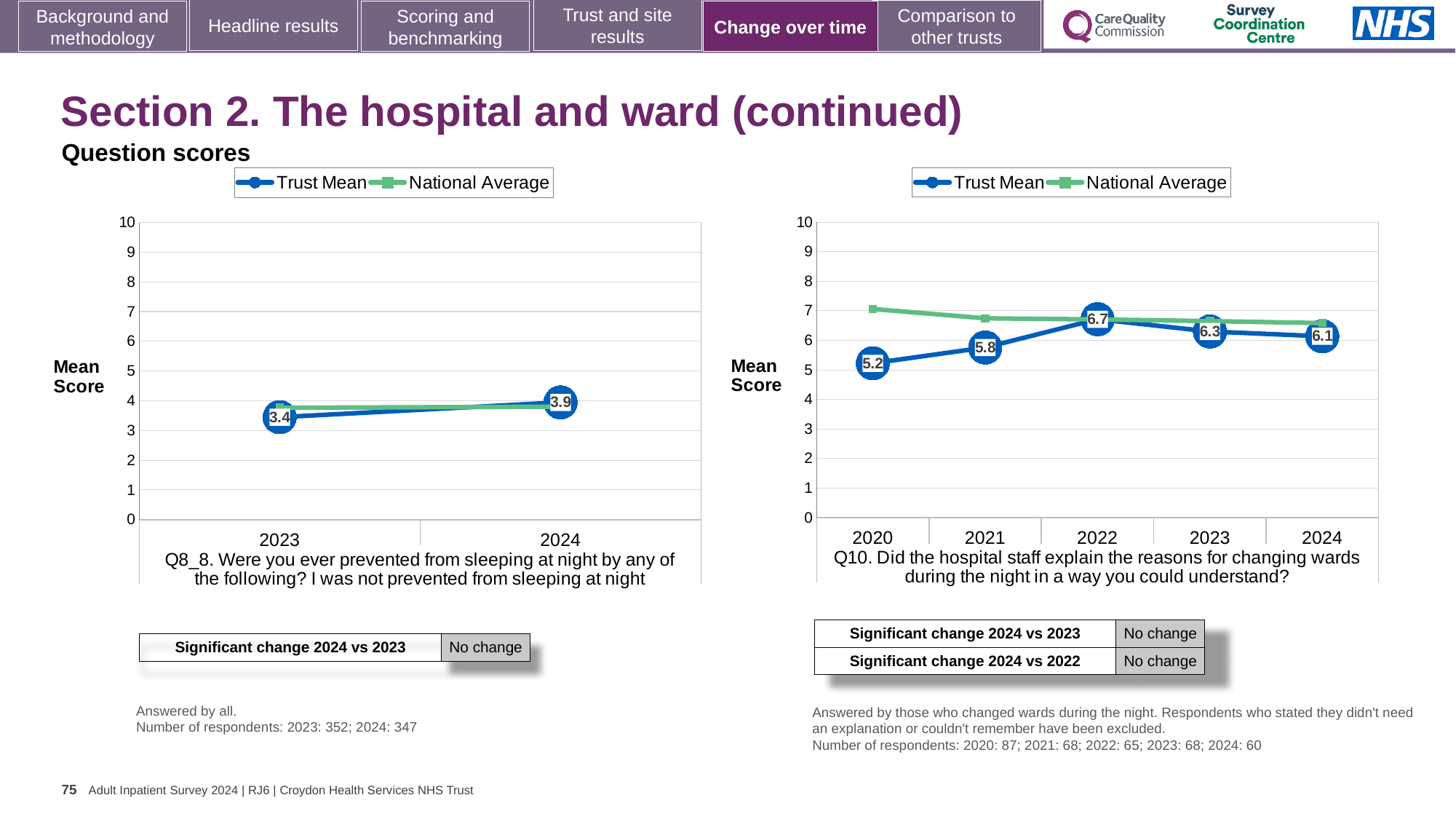
In the right chart (Q10), which year has the highest Trust Mean score? 2022 In the right chart (Q10), is the Trust Mean score for 2021 larger or smaller than the score for 2023? smaller In the left chart (Q8_8), what is the Trust Mean score for 2024? 3.9 In the right chart (Q10), which year has the lowest Trust Mean score? 2020 In the right chart (Q10), what is the Trust Mean score for 2020? 5.2 How many years are plotted on the x axis of the right chart (Q10)? 5 In the left chart (Q8_8), what is the Trust Mean score for 2023? 3.4 In the right chart (Q10), what is the difference between the Trust Mean scores for 2022 and 2024? 0.6 In the left chart (Q8_8), by how much did the Trust Mean change from 2023 to 2024? 0.5 What kind of chart is the left chart (Q8_8)? Line chart In the right chart (Q10), what is the Trust Mean score for 2022? 6.7 In the right chart (Q10), is the National Average for 2020 greater or less than 6? greater